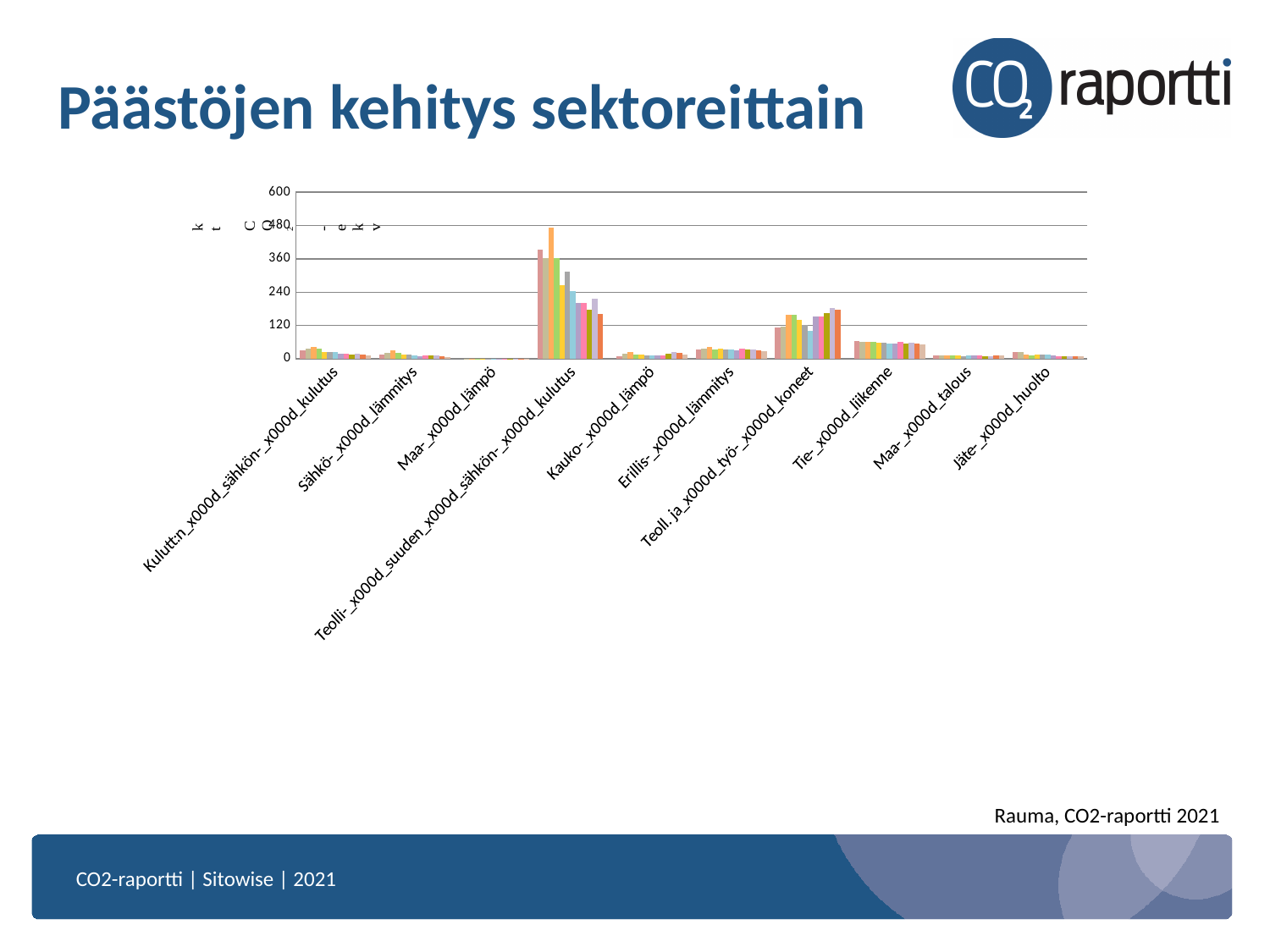
How many categories are shown along the x axis of the chart? 10 What is the title of the slide containing the chart? Päästöjen kehitys sektoreittain Which category has higher bars, Tie-_x000d_liikenne or Erillis-_x000d_lämmitys? Tie-_x000d_liikenne Which category has higher bars, Teolli-_x000d_suuden_x000d_sähkön-_x000d_kulutus or Tie-_x000d_liikenne? Teolli-_x000d_suuden_x000d_sähkön-_x000d_kulutus What is the highest value shown on the y axis of the chart? 600 Which category has the tallest bars in the chart? Teolli-_x000d_suuden_x000d_sähkön-_x000d_kulutus Which category has the lowest bars in the chart? Maa-_x000d_lämpö Are the bars for Tie-_x000d_liikenne greater or less than 240? less Are the bars for Erillis-_x000d_lämmitys greater or less than 120? less Is the tallest bar in the Teolli-_x000d_suuden_x000d_sähkön-_x000d_kulutus category greater or less than 360? greater What kind of chart is shown on the slide? bar chart Within the Teolli-_x000d_suuden_x000d_sähkön-_x000d_kulutus category, do the bars generally rise or fall from left to right? fall